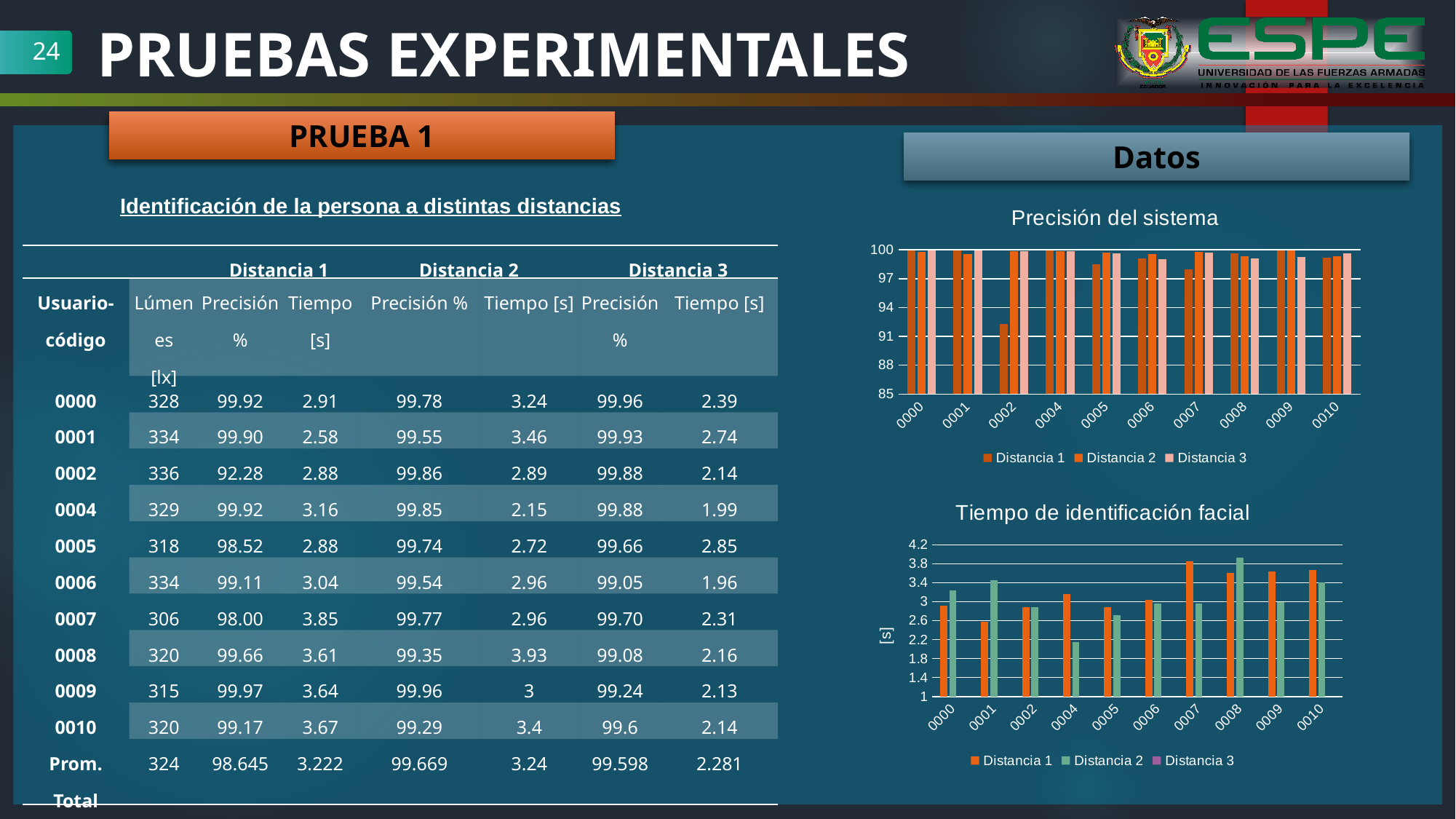
How many user codes are shown on the x axis of the 'Precisión del sistema' chart? 10 In the 'Precisión del sistema' chart, is the Distancia 1 value for 0005 greater or less than 97? greater In the 'Tiempo de identificación facial' chart, for user 0004, which is larger: Distancia 1 or Distancia 2? Distancia 1 In the 'Precisión del sistema' chart, is the Distancia 1 value for 0002 greater or less than 94? less What is the y-axis label of the 'Tiempo de identificación facial' chart? [s] How many series does the legend of the 'Tiempo de identificación facial' chart list? 3 In the 'Tiempo de identificación facial' chart, is the Distancia 1 value for 0007 greater or less than 3.4? greater In the 'Tiempo de identificación facial' chart, which user code has the tallest Distancia 2 bar? 0008 In the 'Tiempo de identificación facial' chart, which user code has the shortest Distancia 2 bar? 0004 In the 'Precisión del sistema' chart, which user code has the lowest Distancia 1 bar? 0002 What kind of chart is the 'Precisión del sistema' chart? bar chart